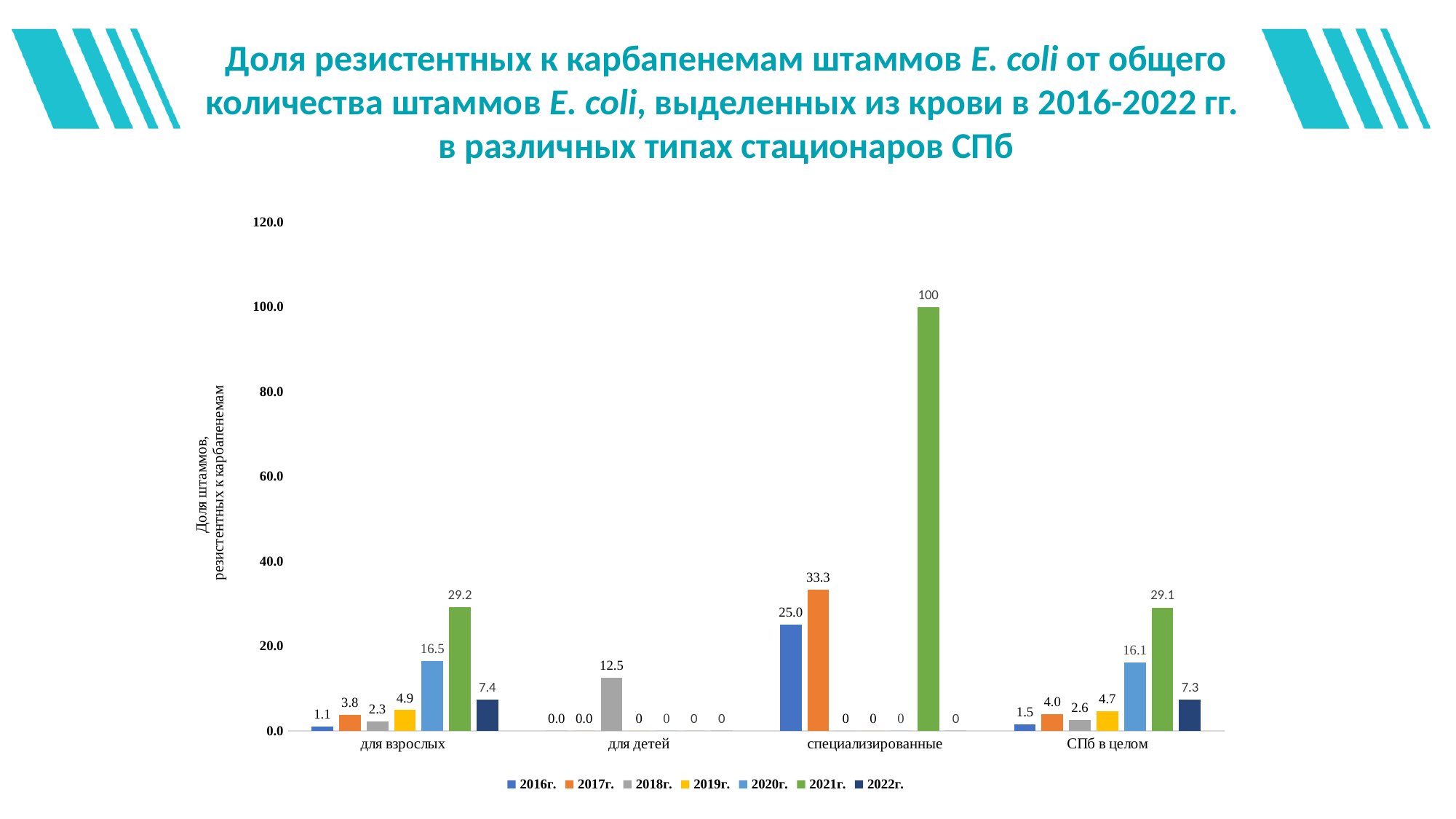
How many series does the legend list? 7 Which series has the lowest value in the "для взрослых" category? 2016г. What is the value for 2017г. in the "специализированные" category? 33.3 What is the label of the vertical axis? Доля штаммов, резистентных к карбапенемам Which is larger: the 2016г. value for "специализированные" or the 2020г. value for "для взрослых"? 2016г. value for специализированные What is the value for 2018г. in the "для детей" category? 12.5 How many categories are shown on the x axis? 4 What is the value for 2021г. in the "для взрослых" category? 29.2 What kind of chart is shown on the slide? Bar chart What is the value for 2020г. in the "СПб в целом" category? 16.1 What is the difference between the 2021г. and 2020г. values in the "СПб в целом" category? 13.0 Which series has the highest value in the "специализированные" category? 2021г.